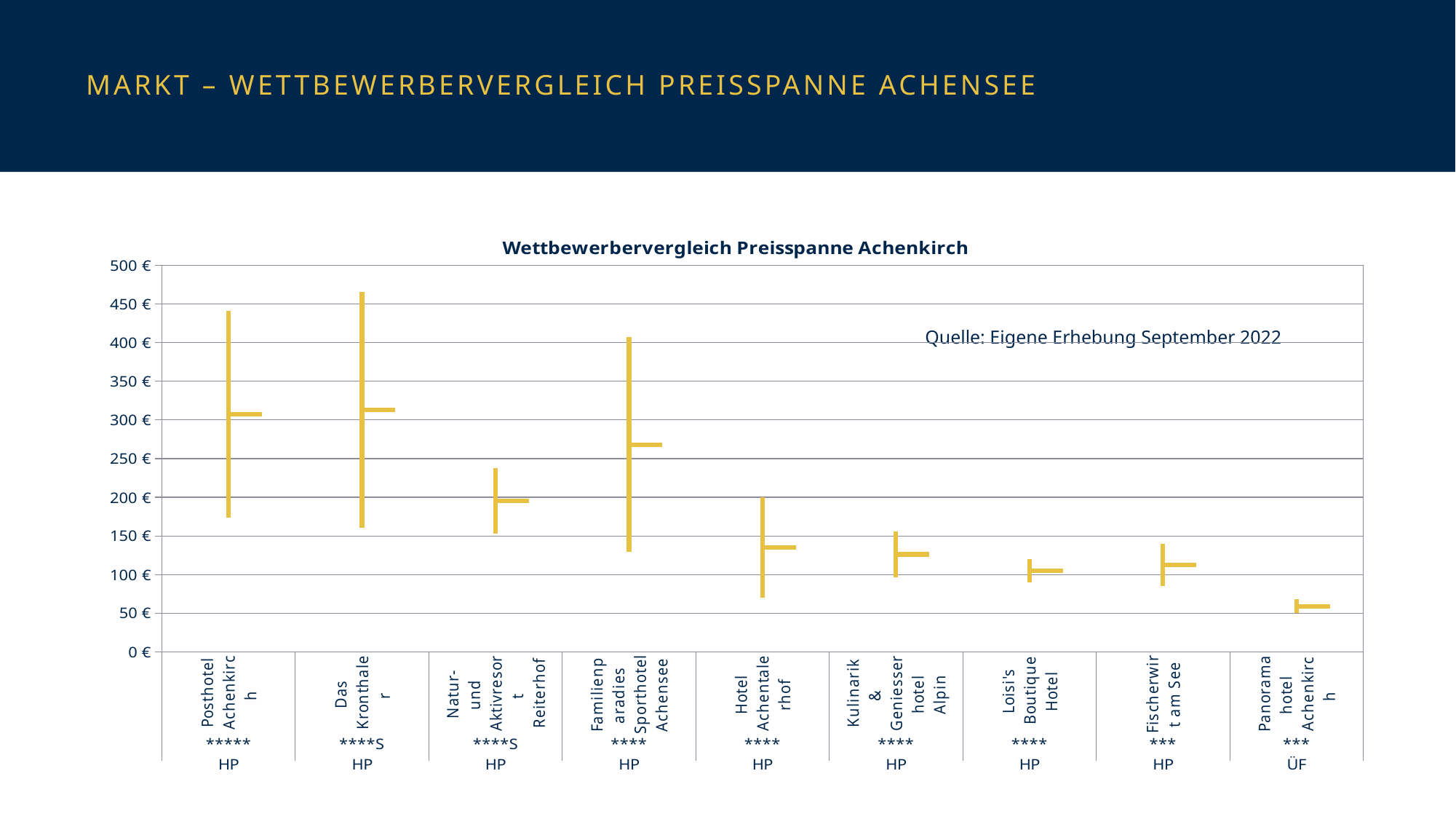
Is the upper end of the price range for Posthotel Achenkirch greater or less than 400 €? greater Is the upper end of the price range for Das Kronthaler greater or less than 450 €? greater Is the lower end of the price range for Hotel Achentalerhof greater or less than 100 €? less What is the title of the chart? Wettbewerbervergleich Preisspanne Achenkirch Which hotel has the lowest price range on the chart? Panorama hotel Achenkirch Which hotel has the highest upper end of its price range? Das Kronthaler How many hotels (categories) are shown on the x axis of the chart? 9 What source note is printed inside the chart area? Quelle: Eigene Erhebung September 2022